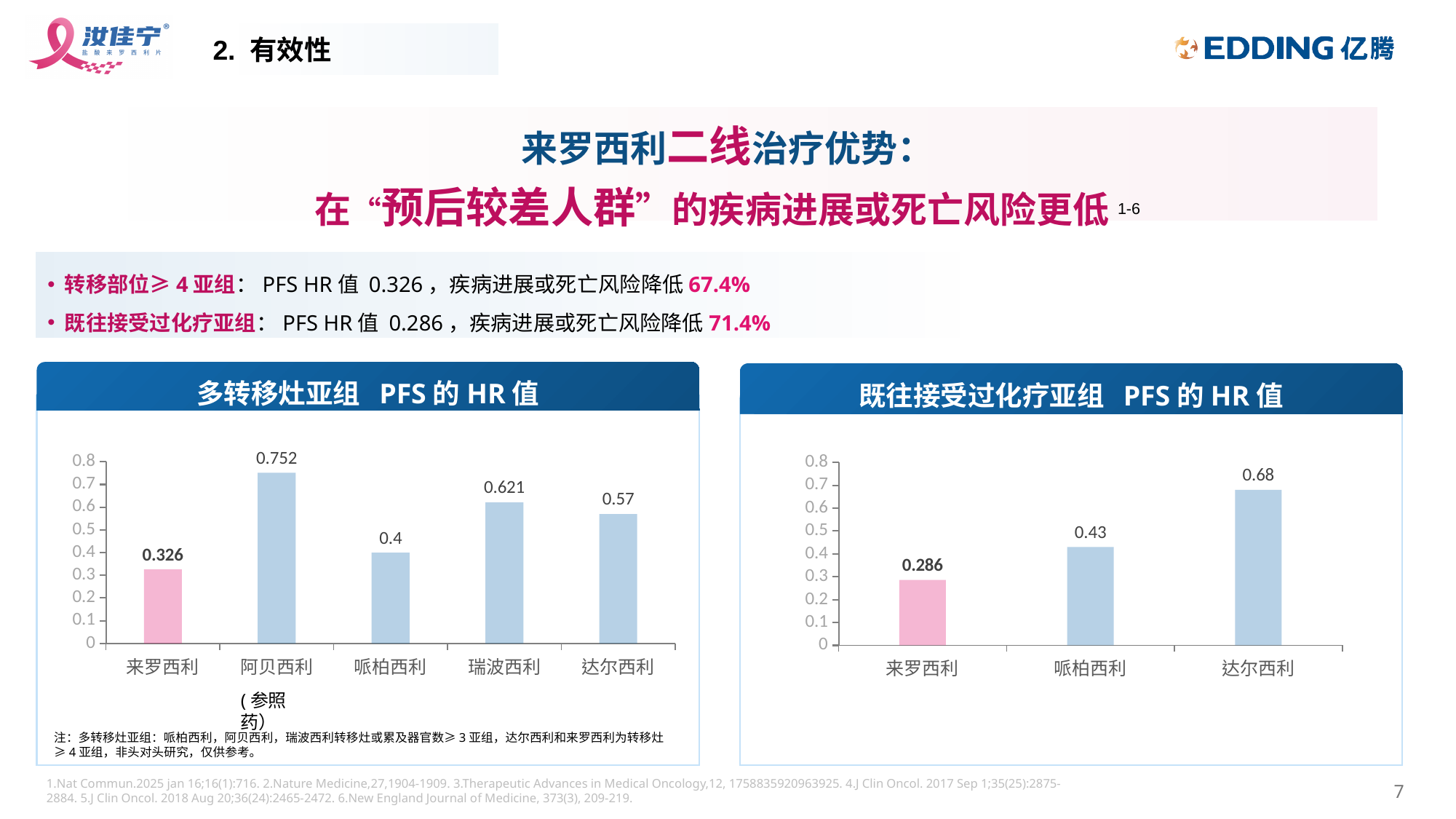
In the chart titled 既往接受过化疗亚组 PFS的HR值, what is the difference between the HR values of 达尔西利 and 来罗西利? 0.394 In the chart titled 多转移灶亚组 PFS的HR值, what is the HR value for 阿贝西利? 0.752 In the chart titled 既往接受过化疗亚组 PFS的HR值, what is the HR value for 哌柏西利? 0.43 In the chart titled 多转移灶亚组 PFS的HR值, which drug has the highest HR value? 阿贝西利 In the chart titled 既往接受过化疗亚组 PFS的HR值, which drug has the lowest HR value? 来罗西利 In the chart titled 既往接受过化疗亚组 PFS的HR值, how many drugs are plotted? 3 In the chart titled 多转移灶亚组 PFS的HR值, what is the HR value for 来罗西利? 0.326 What type of chart is the chart titled 既往接受过化疗亚组 PFS的HR值? Bar chart In the chart titled 多转移灶亚组 PFS的HR值, what is the difference between the HR values of 瑞波西利 and 达尔西利? 0.051 In the chart titled 多转移灶亚组 PFS的HR值, how many drugs are plotted? 5 In the chart titled 既往接受过化疗亚组 PFS的HR值, what is the HR value for 达尔西利? 0.68 In the chart titled 多转移灶亚组 PFS的HR值, which drug has the lowest HR value? 来罗西利